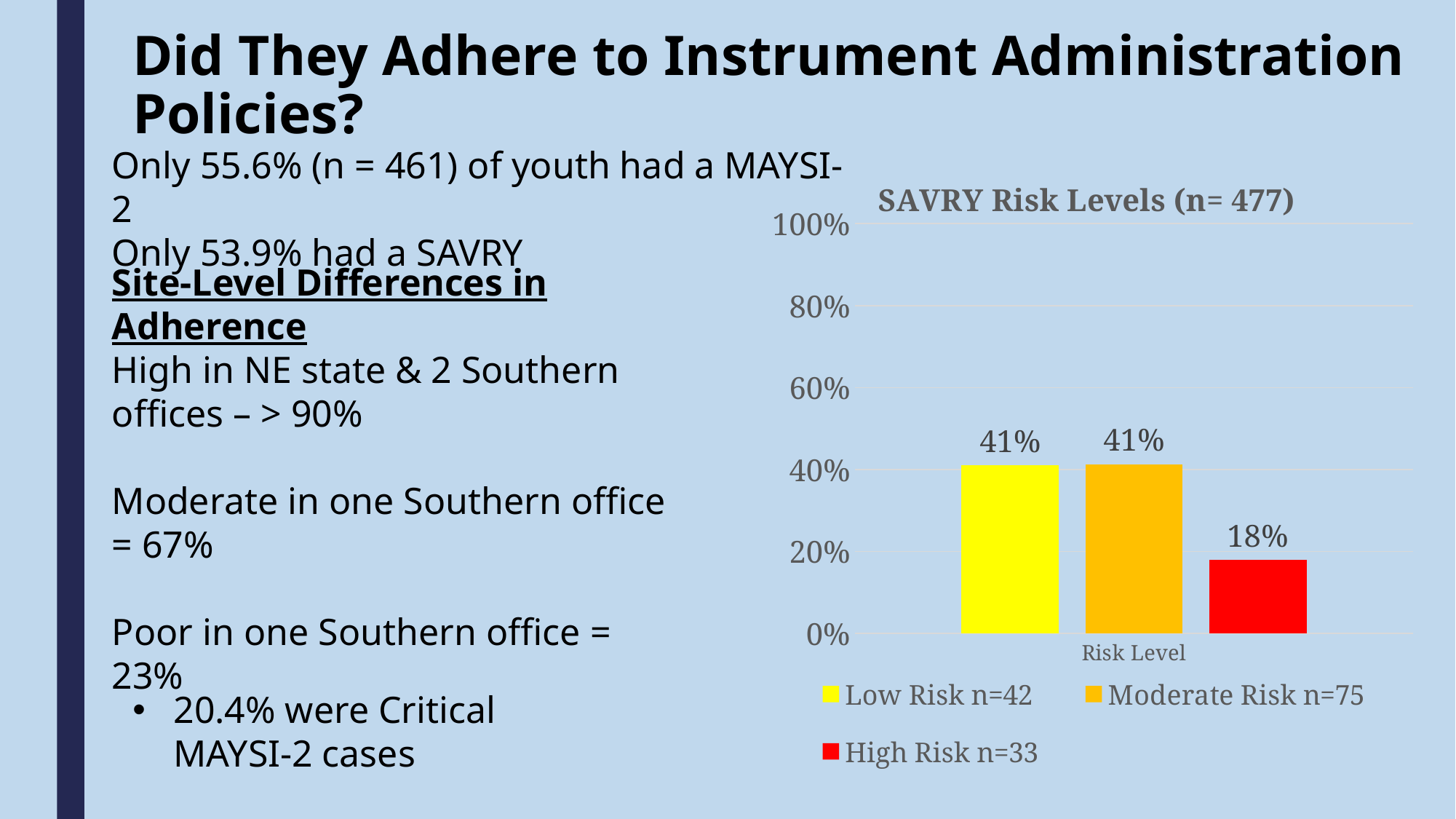
Which risk level has the lowest percentage in the SAVRY Risk Levels chart? High Risk What is the value shown for Moderate Risk in the SAVRY Risk Levels chart? 41% How many bars are plotted in the SAVRY Risk Levels chart? 3 What is the difference between the Low Risk and High Risk percentages in the SAVRY Risk Levels chart? 23% How many series does the legend of the SAVRY Risk Levels chart list? 3 Is the value for High Risk in the SAVRY Risk Levels chart greater or less than 20%? less What is the total of the three percentages shown in the SAVRY Risk Levels chart? 100% What is the value shown for Low Risk in the SAVRY Risk Levels chart? 41% What kind of chart is the SAVRY Risk Levels chart? Bar chart Which is larger in the SAVRY Risk Levels chart, Moderate Risk or High Risk? Moderate Risk What is the value shown for High Risk in the SAVRY Risk Levels chart? 18% What colour is the High Risk bar in the SAVRY Risk Levels chart? Red